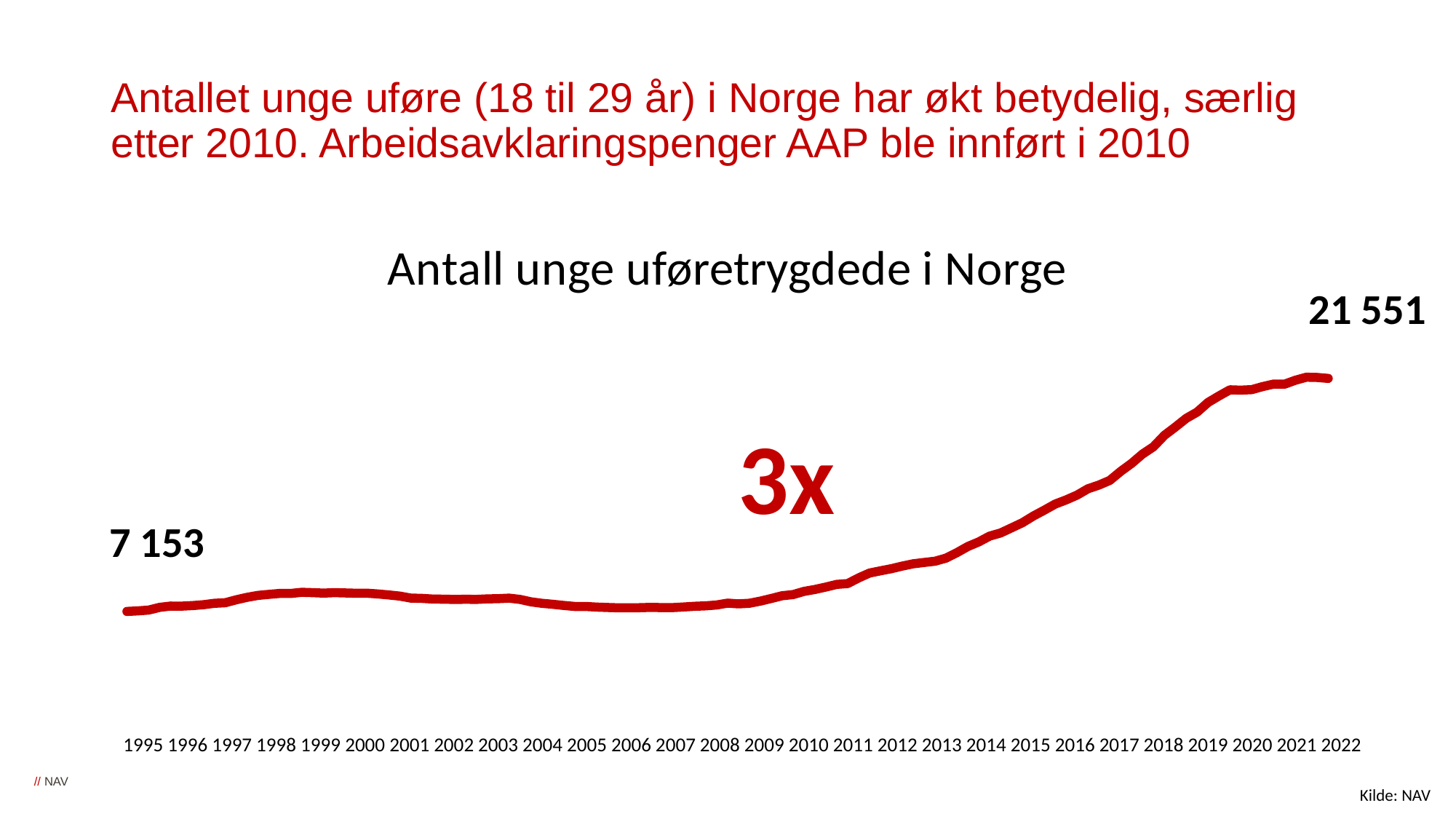
What is the value for 2022 in the chart "Antall unge uføretrygdede i Norge"? 21 551 Which is larger, the value for 2022 or the value for 1995? 2022 Which is larger, the value for 2003 or the value for 2013? 2013 Do the values rise or fall from 2010 to 2022? Rise What kind of chart is shown on the slide? Line chart What is the title of the chart? Antall unge uføretrygdede i Norge Which is larger, the value for 2015 or the value for 2005? 2015 What annotation is printed in large red text in the middle of the chart? 3x What is the difference between the 2022 value and the 1995 value in the chart? 14 398 Which year has the highest value in the chart? 2022 How many years are shown on the x axis of the chart? 28 What is the value for 1995 in the chart "Antall unge uføretrygdede i Norge"? 7 153